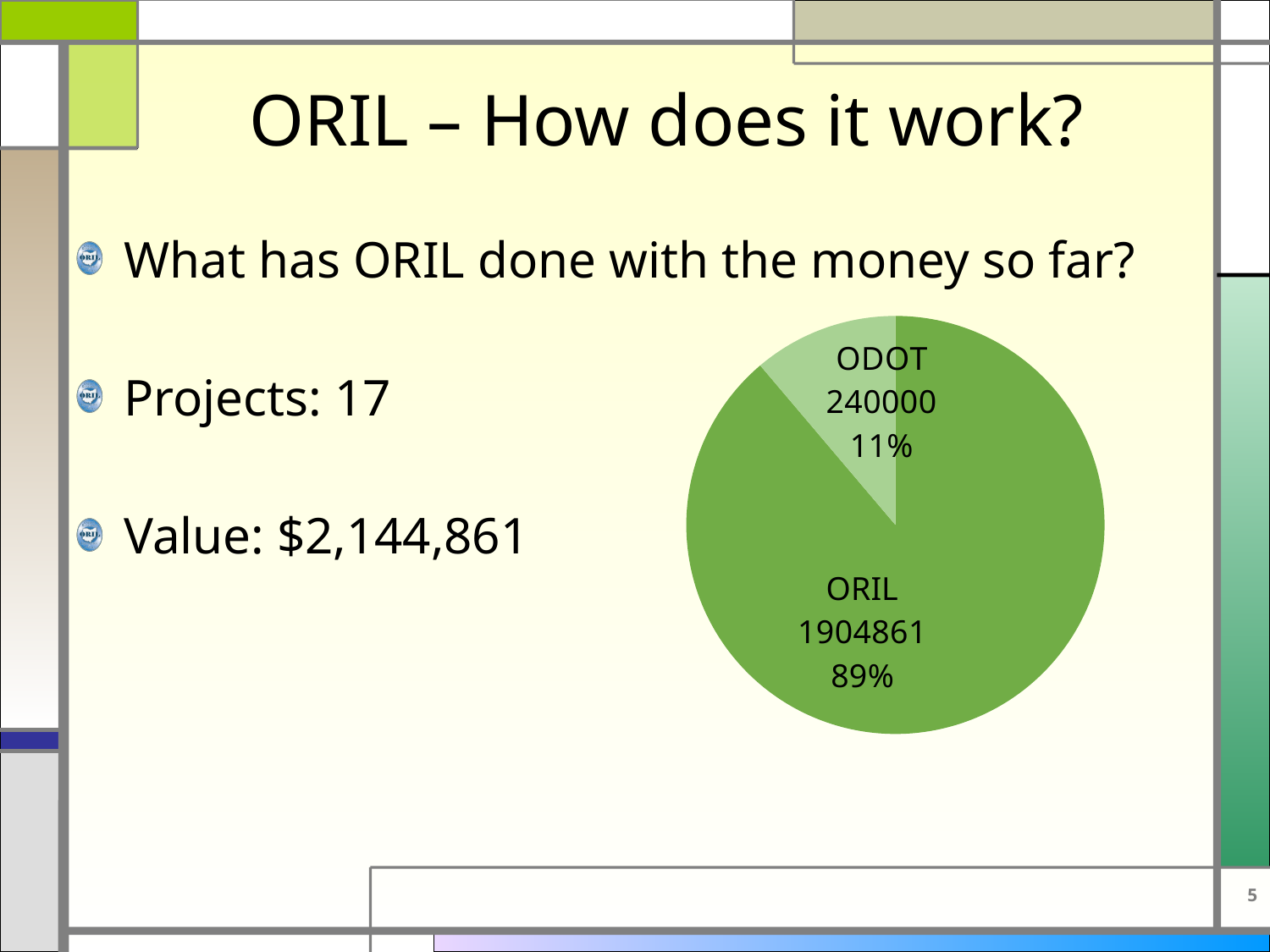
What is the value for ORIL in the pie chart? 1904861 What is the value for ODOT in the pie chart? 240000 Which is larger in the pie chart, ORIL or ODOT? ORIL Which slice of the pie chart is shown in the lighter green colour? ODOT What share of the pie does ODOT represent? 11% Which slice of the pie chart is the smallest? ODOT What is the difference between the ORIL and ODOT values in the pie chart? 1664861 What is the total of the two values shown in the pie chart? 2144861 Which slice of the pie chart is the largest? ORIL How many slices does the pie chart have? 2 What kind of chart is shown on the slide? pie chart What share of the pie does ORIL represent? 89%